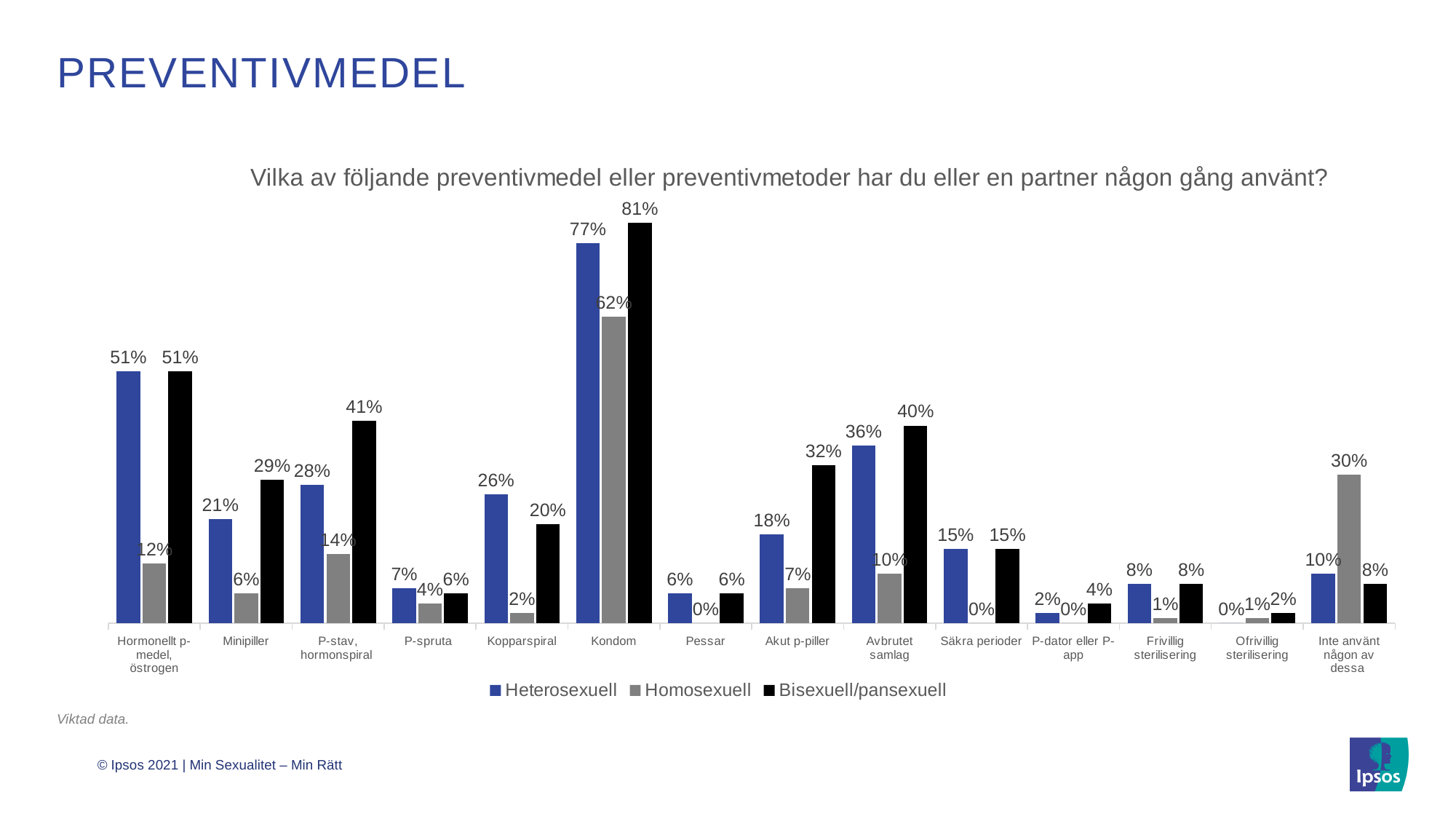
How many categories are shown on the x axis? 14 For Avbrutet samlag, which series has the larger value: Heterosexuell or Bisexuell/pansexuell? Bisexuell/pansexuell Which category has the lowest value for the Heterosexuell series? Ofrivillig sterilisering What is the difference between the Bisexuell/pansexuell and Homosexuell values for Kondom? 19% How many series does the legend list? 3 Which colour represents the Homosexuell series in the legend? Grey What is the value for Heterosexuell for Kondom? 77% What is the difference between the Heterosexuell and Homosexuell values for Hormonellt p-medel, östrogen? 39% Which category has the highest value for the Bisexuell/pansexuell series? Kondom What is the value for Homosexuell for Inte använt någon av dessa? 30% What is the value for Bisexuell/pansexuell for P-stav, hormonspiral? 41% What kind of chart is shown on the slide? Bar chart